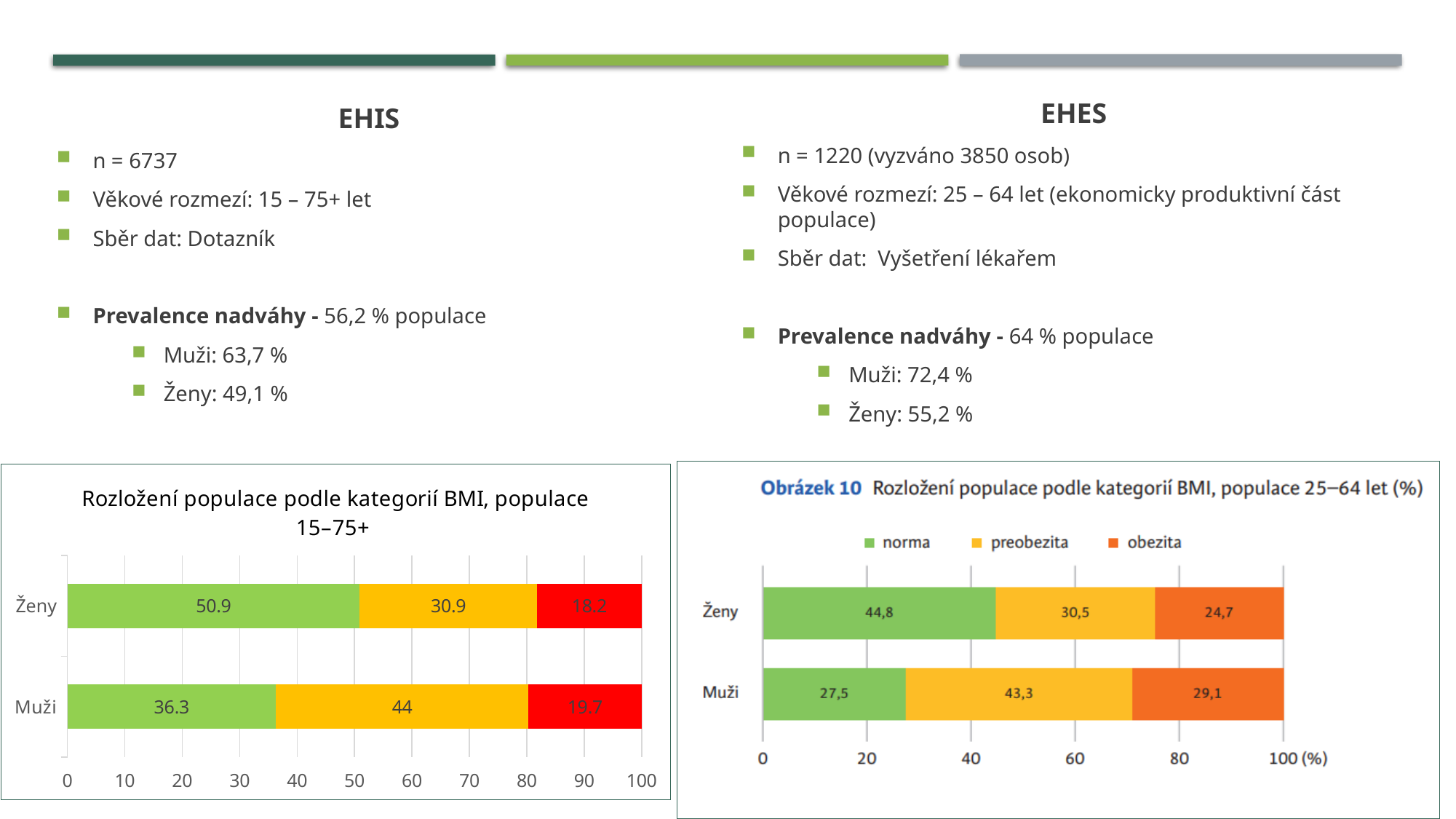
In the left chart (populace 15–75+), what is the value of the yellow segment for Muži? 44 In the left chart (populace 15–75+), what is the value of the red segment for Ženy? 18.2 In the left chart (populace 15–75+), what is the value of the green segment for Ženy? 50.9 What kind of chart is the left chart (populace 15–75+)? Stacked bar chart In the left chart (populace 15–75+), which is larger: the red segment for Muži or the red segment for Ženy? Muži In the right chart (Obrázek 10, populace 25–64 let), what is the norma value for Muži? 27,5 How many series does the legend of the right chart (Obrázek 10, populace 25–64 let) list? 3 In the left chart (populace 15–75+), what is the difference between the green segment for Ženy and the green segment for Muži? 14.6 In the right chart (Obrázek 10, populace 25–64 let), what is the obezita value for Ženy? 24,7 In the left chart (populace 15–75+), how many categories are shown on the vertical axis? 2 In the right chart (Obrázek 10, populace 25–64 let), what is the difference between the obezita values for Muži and Ženy? 4,4 In the right chart (Obrázek 10, populace 25–64 let), which category has the higher preobezita value, Ženy or Muži? Muži